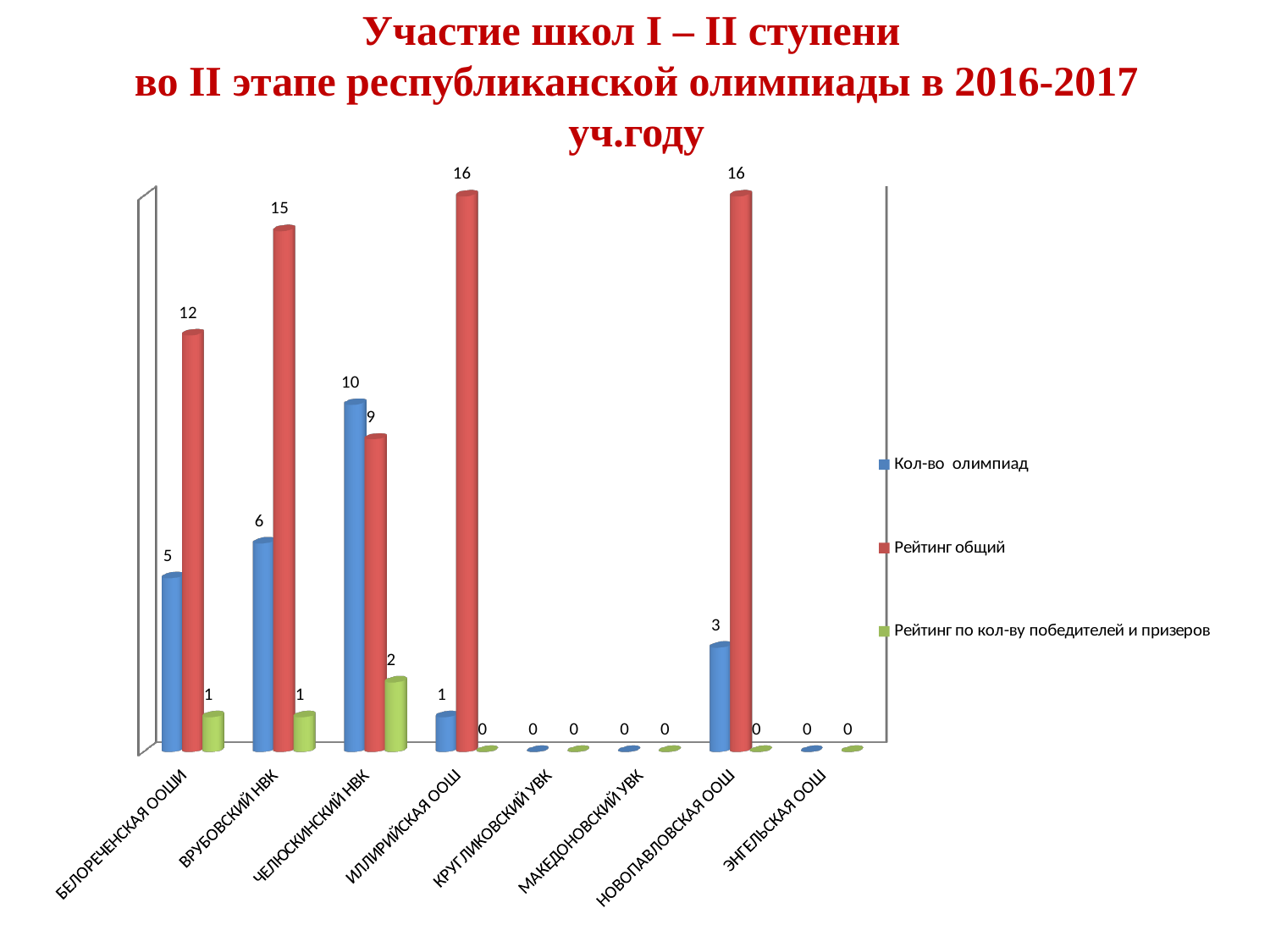
What is the value of Рейтинг общий for ИЛЛИРИЙСКАЯ ООШ? 16 What is the value of Рейтинг общий for ВРУБОВСКИЙ НВК? 15 What is the difference between the Рейтинг общий values for ВРУБОВСКИЙ НВК and БЕЛОРЕЧЕНСКАЯ ООШИ? 3 Which school has the highest value of Кол-во олимпиад? ЧЕЛЮСКИНСКИЙ НВК Which school has the highest value of Рейтинг по кол-ву победителей и призеров? ЧЕЛЮСКИНСКИЙ НВК How many series does the legend list? 3 What is the value of Кол-во олимпиад for НОВОПАВЛОВСКАЯ ООШ? 3 How many schools are shown on the x axis of the chart? 8 Which school has the larger Кол-во олимпиад value: БЕЛОРЕЧЕНСКАЯ ООШИ or ВРУБОВСКИЙ НВК? ВРУБОВСКИЙ НВК What is the value of Кол-во олимпиад for ЧЕЛЮСКИНСКИЙ НВК? 10 What is the value of Рейтинг по кол-ву победителей и призеров for ЧЕЛЮСКИНСКИЙ НВК? 2 What kind of chart is shown on the slide? Bar chart